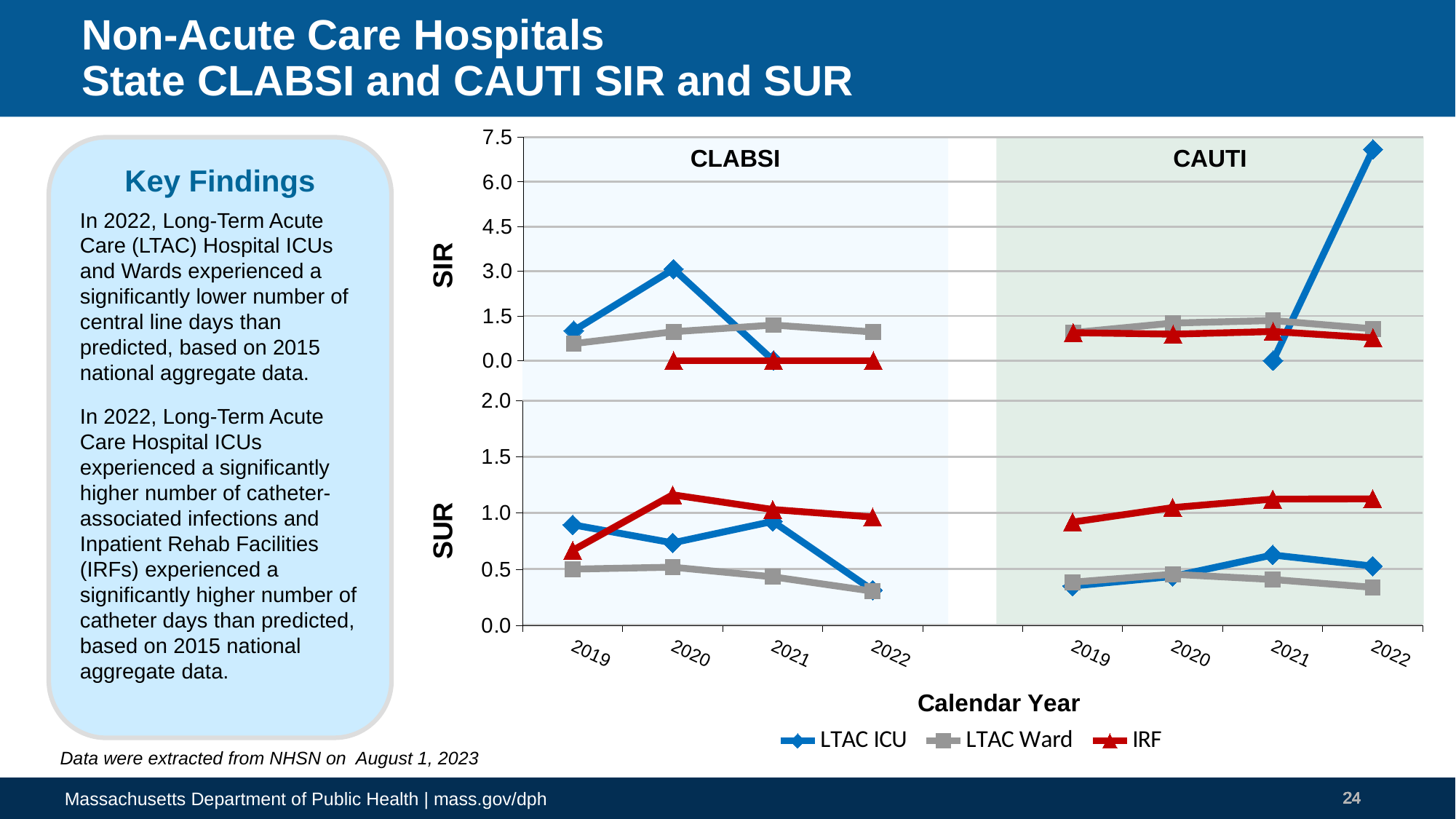
What are the three series named in the legend? LTAC ICU, LTAC Ward, IRF How many calendar years are shown on the x axis for the CLABSI section? 4 How many series does the legend list? 3 In the CLABSI SIR panel, which year has the highest LTAC ICU value? 2020 What kind of chart is shown on the slide? line chart In the CAUTI SIR panel, is the LTAC ICU value for 2022 greater or less than 6.0? greater In the CLABSI SUR panel, is the IRF value for 2020 greater or less than 1.0? greater In the CAUTI SUR panel, does the IRF line rise or fall from 2019 to 2021? rise In the CLABSI SUR panel, is the LTAC Ward value for 2022 greater or less than 0.5? less In the CAUTI SIR panel, which year has the highest LTAC ICU value? 2022 In the CLABSI SUR panel, which is larger in 2020: IRF or LTAC Ward? IRF